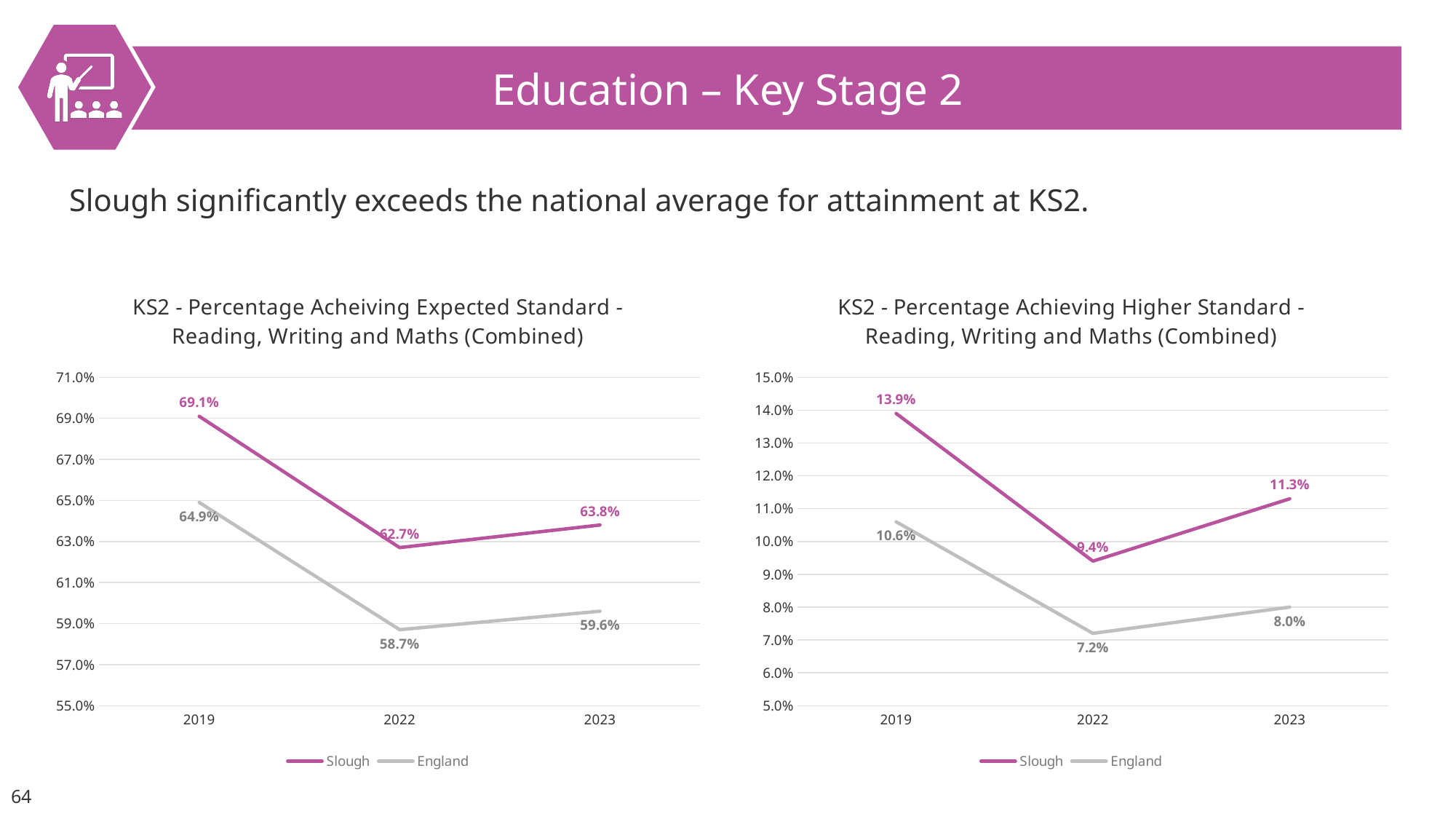
In the 'KS2 - Percentage Acheiving Expected Standard' chart on the left, what is the value for Slough in 2019? 69.1% In the 'KS2 - Percentage Achieving Higher Standard' chart on the right, in which year is the Slough value highest? 2019 What kind of chart is the 'KS2 - Percentage Achieving Higher Standard' chart on the right? Line chart In the 'KS2 - Percentage Acheiving Expected Standard' chart on the left, does the England value rise or fall from 2019 to 2022? Fall In the 'KS2 - Percentage Acheiving Expected Standard' chart on the left, what is the value for England in 2022? 58.7% In the 'KS2 - Percentage Achieving Higher Standard' chart on the right, what is the value for England in 2019? 10.6% In the 'KS2 - Percentage Achieving Higher Standard' chart on the right, what is the value for Slough in 2023? 11.3% In the 'KS2 - Percentage Achieving Higher Standard' chart on the right, what is the difference between the Slough values in 2019 and 2022? 4.5% In the 'KS2 - Percentage Achieving Higher Standard' chart on the right, which is larger in 2022: the Slough value or the England value? Slough How many series does the legend list in the 'KS2 - Percentage Acheiving Expected Standard' chart on the left? 2 In the 'KS2 - Percentage Acheiving Expected Standard' chart on the left, in which year is the Slough value lowest? 2022 In the 'KS2 - Percentage Acheiving Expected Standard' chart on the left, what is the difference between the Slough and England values in 2023? 4.2%